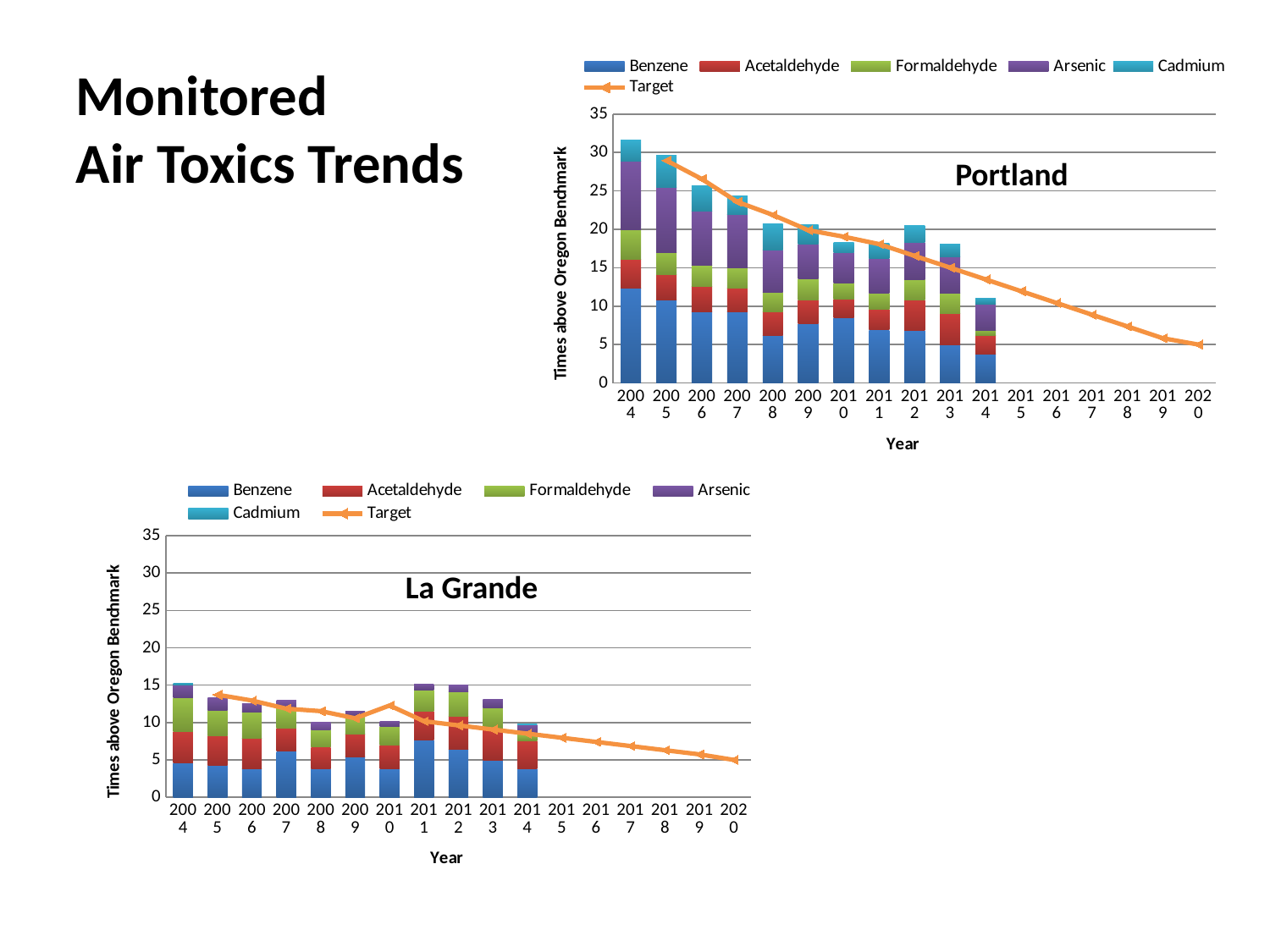
In the Portland chart, how many years have stacked bars plotted? 11 In the La Grande chart, how many years are labelled on the x axis? 17 In the Portland chart, does the Target line rise or fall from 2005 to 2020? Falls In the Portland chart, which year has the tallest stacked bar? 2004 What is the y-axis label on the La Grande chart? Times above Oregon Benchmark In the Portland chart, which year has the shortest stacked bar? 2014 In the Portland chart, is the total stacked value for 2004 greater or less than 30? greater In the Portland chart, is the total stacked value for 2014 greater or less than 15? less How many series does the legend of the La Grande chart list? 6 What kind of chart is the Portland chart? Stacked bar chart with a line In the Portland chart, is the stacked bar for 2004 taller or shorter than the stacked bar for 2014? Taller In the La Grande chart, is the total stacked value for 2011 greater or less than 10? greater